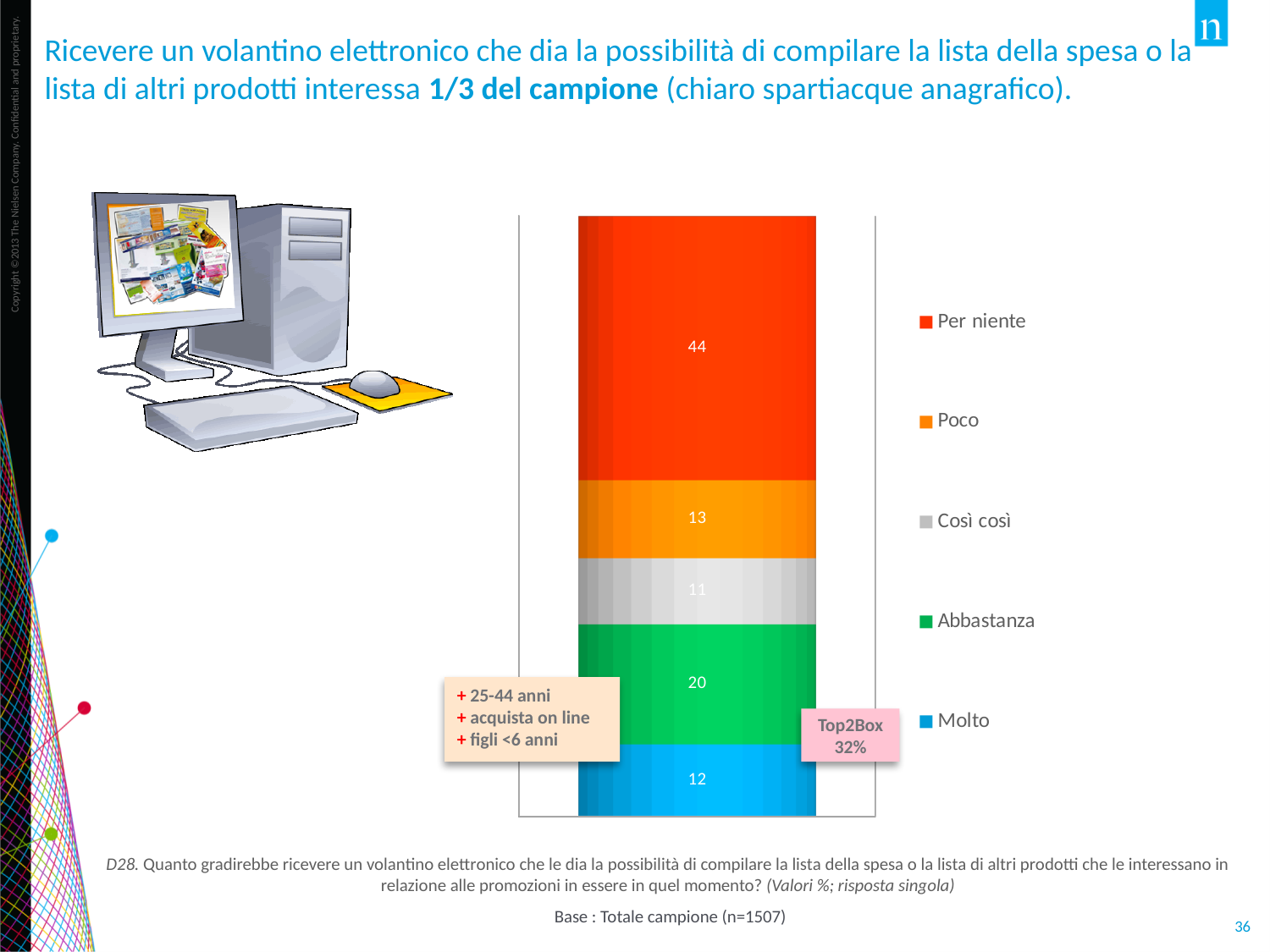
What Top2Box percentage is shown next to the bar? 32% How many series does the legend list? 5 What value is shown for the "Abbastanza" segment of the stacked bar? 20 Which response category has the largest segment in the stacked bar? Per niente What is the difference between the "Per niente" value and the "Abbastanza" value? 24 What value is shown for the "Molto" segment of the stacked bar? 12 Which response category has the smallest segment in the stacked bar? Così così What value is shown for the "Per niente" segment of the stacked bar? 44 What is the total of all segments in the stacked bar? 100 Which is larger, the "Poco" segment or the "Molto" segment? Poco What value is shown for the "Poco" segment of the stacked bar? 13 What kind of chart is shown on the slide? Stacked bar chart